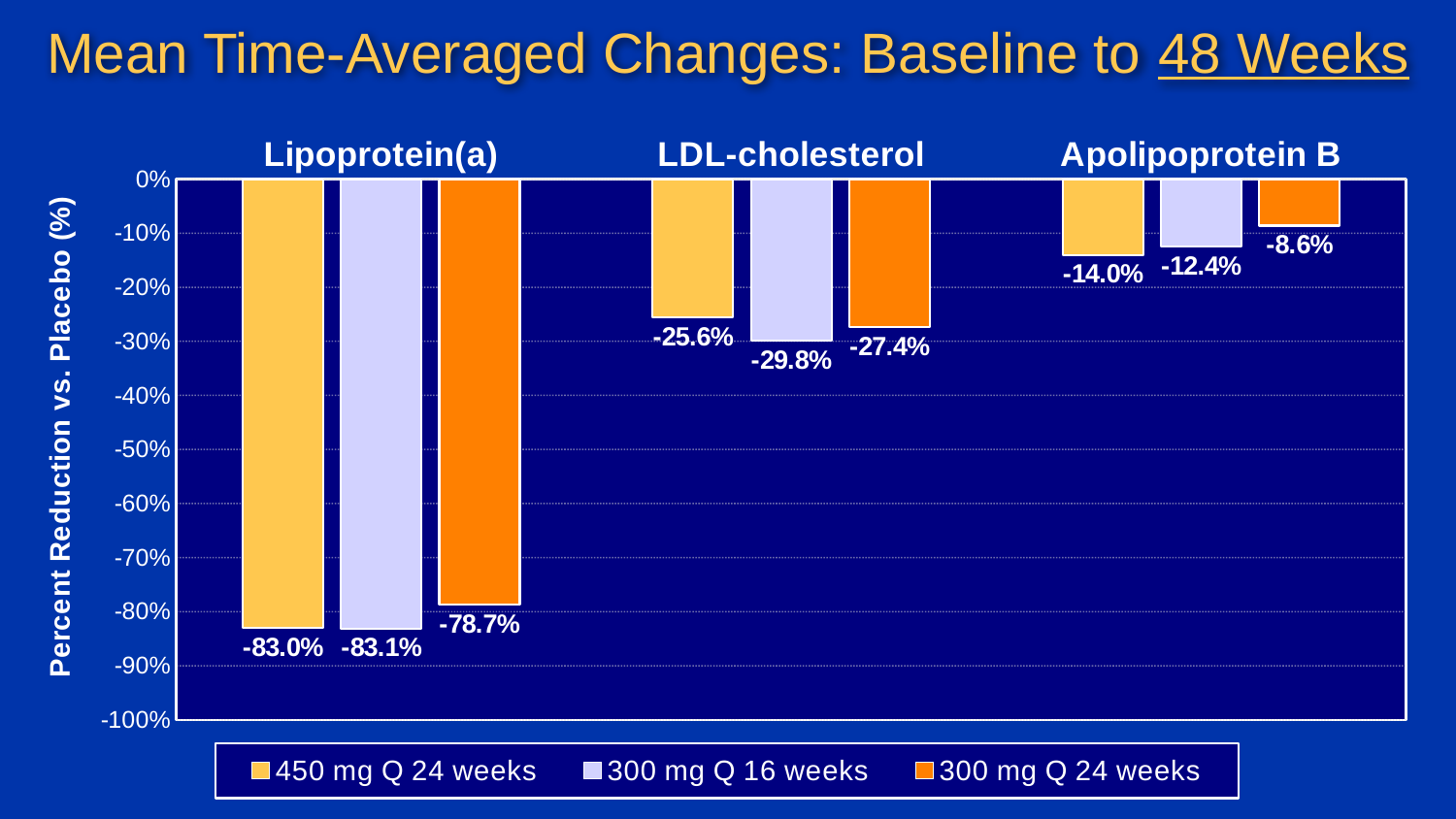
How many categories are shown on the x axis? 3 What is the value for 300 mg Q 24 weeks in the Apolipoprotein B group? -8.6% Which dosing regimen shows the smallest reduction in Apolipoprotein B? 300 mg Q 24 weeks What is the value for 300 mg Q 16 weeks in the Lipoprotein(a) group? -83.1% What is the label of the y axis? Percent Reduction vs. Placebo (%) How many series does the legend list? 3 Which is a larger reduction: 300 mg Q 24 weeks for LDL-cholesterol or 300 mg Q 24 weeks for Apolipoprotein B? LDL-cholesterol What is the value for 450 mg Q 24 weeks in the LDL-cholesterol group? -25.6% What is the difference between the 450 mg Q 24 weeks and 300 mg Q 24 weeks values in the Lipoprotein(a) group? 4.3 percentage points What is the title of the chart? Mean Time-Averaged Changes: Baseline to 48 Weeks What kind of chart is shown on the slide? Bar chart Which dosing regimen shows the largest reduction in LDL-cholesterol? 300 mg Q 16 weeks